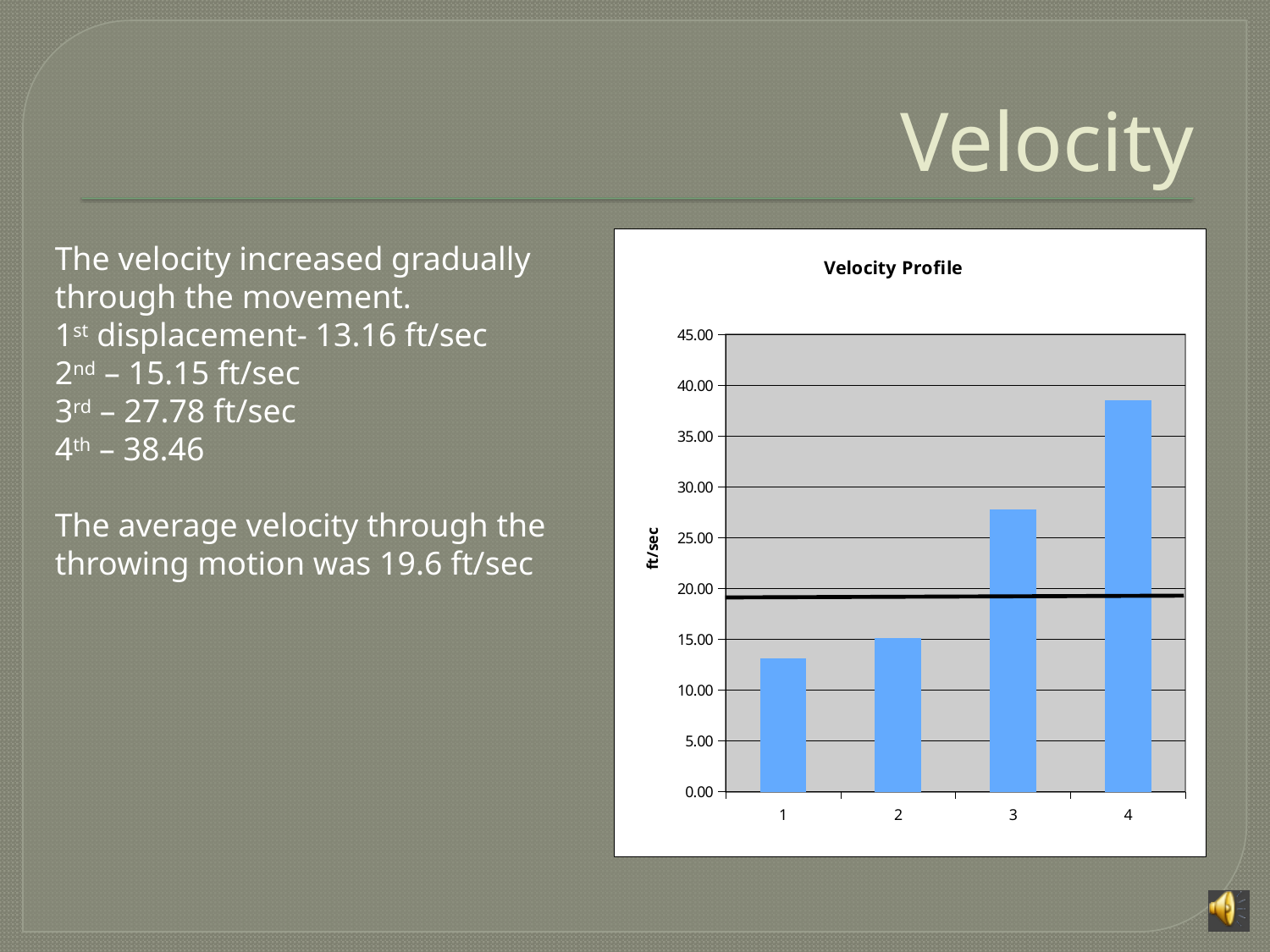
What is the title of the chart? Velocity Profile Which is larger, the bar for category 3 or the bar for category 2? 3 Do the bar values rise or fall from category 1 to category 4? rise According to the slide text, what is the velocity for the 3rd displacement? 27.78 ft/sec What is the label on the vertical axis of the chart? ft/sec Is the value for category 4 greater or less than 40.00? less How many bars are plotted in the chart? 4 Which category has the lowest bar in the chart? 1 Is the value for category 3 greater or less than 25.00? greater What kind of chart is shown on the slide? bar chart Which category has the highest bar in the chart? 4 Is the value for category 1 greater or less than 15.00? less